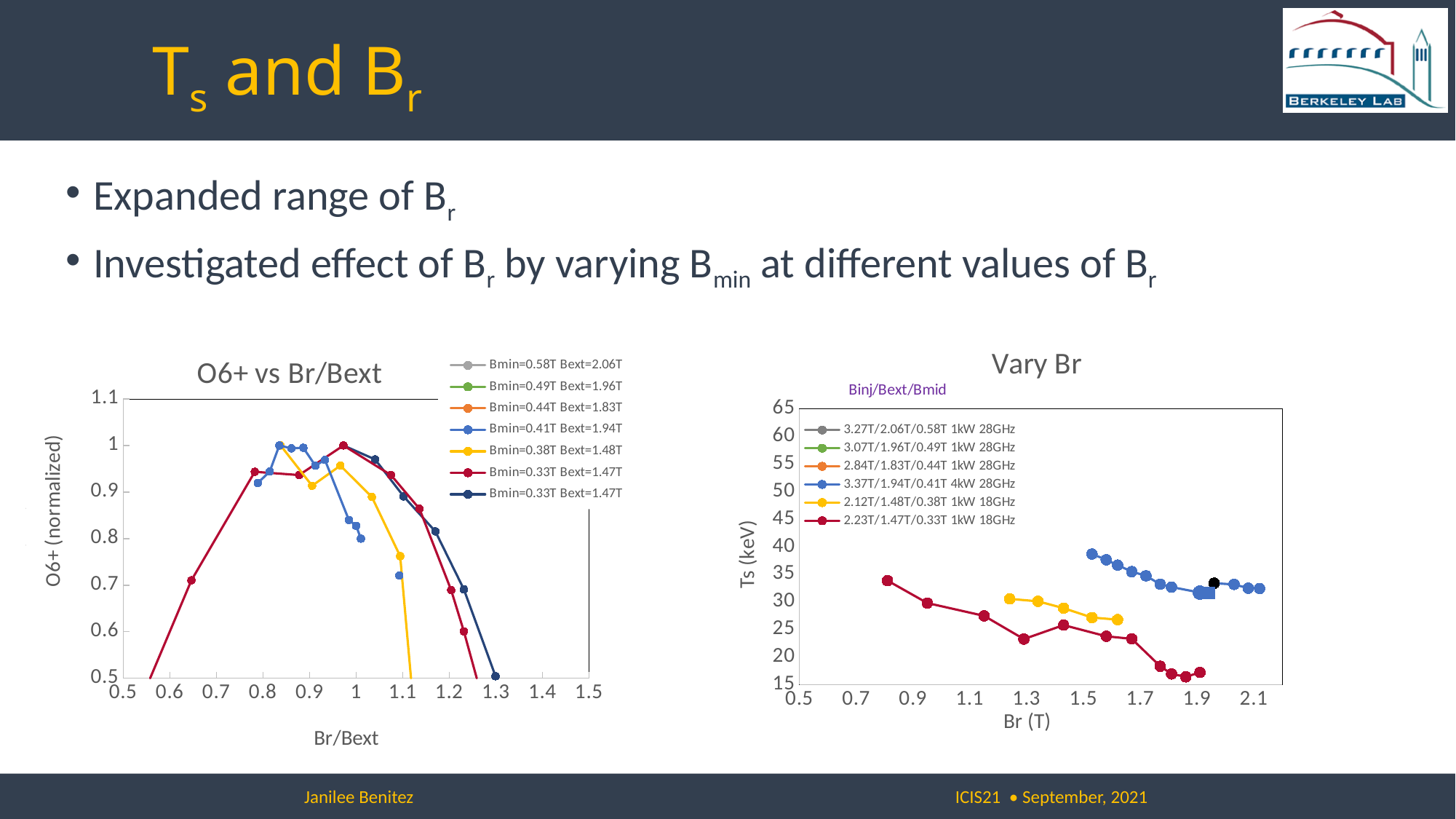
How many series does the legend of the 'O6+ vs Br/Bext' chart list? 7 In the 'Vary Br' chart, do the Ts values of the 2.23T/1.47T/0.33T 1kW 18GHz series rise or fall as Br increases? fall In the 'Vary Br' chart, is the Ts value of the 2.23T/1.47T/0.33T 1kW 18GHz series at Br of about 1.9 T greater or less than 20? less How many series does the legend of the 'Vary Br' chart list? 6 In the 'O6+ vs Br/Bext' chart, is the value of the Bmin=0.38T Bext=1.48T series at Br/Bext of about 1.1 greater or less than 0.7? greater In the 'Vary Br' chart, is the Ts value of the 2.12T/1.48T/0.38T 1kW 18GHz series at Br of about 1.3 T greater or less than 25? greater In the 'O6+ vs Br/Bext' chart, what is the highest normalized O6+ value reached by any series? 1 What type of chart is the 'O6+ vs Br/Bext' chart on the left? line chart In the 'Vary Br' chart, which series has the highest Ts values, 3.37T/1.94T/0.41T 4kW 28GHz or 2.23T/1.47T/0.33T 1kW 18GHz? 3.37T/1.94T/0.41T 4kW 28GHz What is the x-axis title of the 'Vary Br' chart? Br (T) What is the y-axis title of the 'O6+ vs Br/Bext' chart? O6+ (normalized)